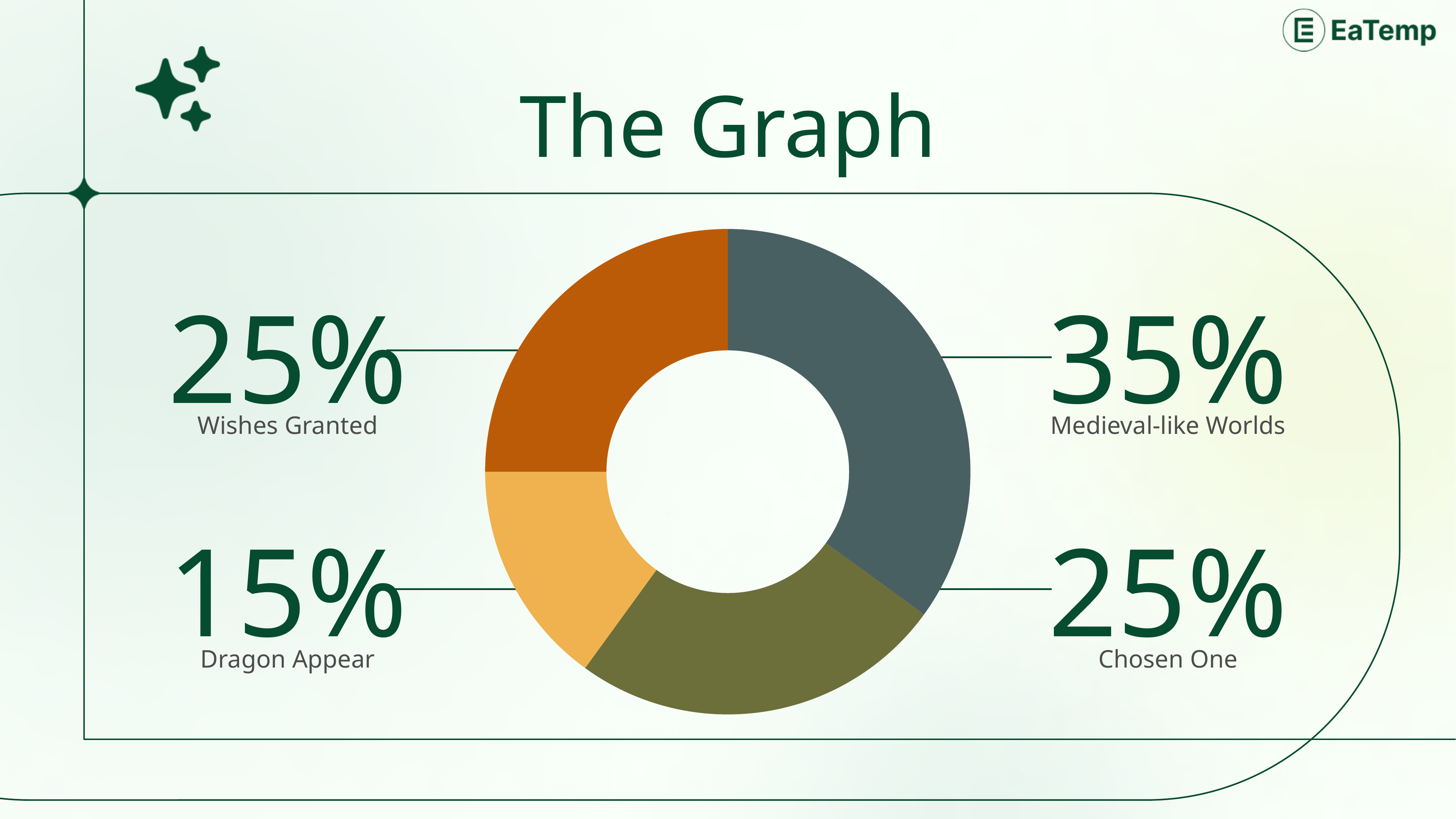
Which is larger, the share for Medieval-like Worlds or the share for Wishes Granted? Medieval-like Worlds What percentage is shown for Chosen One? 25% What is the title of the slide containing the chart? The Graph Which category has the smallest share of the donut chart? Dragon Appear What is the difference in percentage points between Medieval-like Worlds and Dragon Appear? 20 What percentage is shown for Wishes Granted? 25% What percentage is shown for Medieval-like Worlds? 35% What percentage is shown for Dragon Appear? 15% What kind of chart is shown on the slide? Donut chart How many categories are shown in the donut chart? 4 Which category has the largest share of the donut chart? Medieval-like Worlds What is the difference in percentage points between Chosen One and Dragon Appear? 10